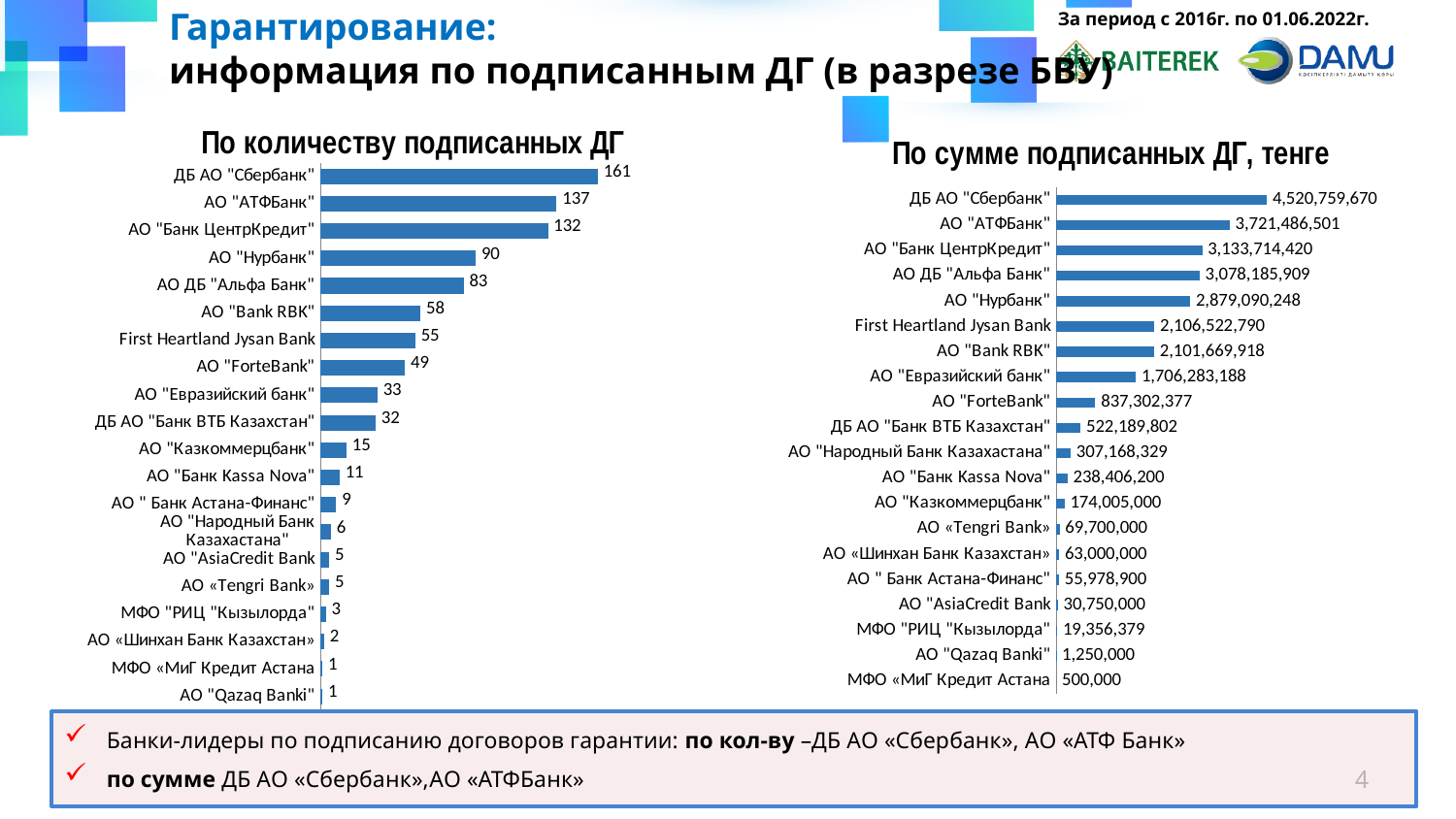
In the chart "По количеству подписанных ДГ", what is the value for АО "Нурбанк"? 90 What is the title of the chart on the right side of the slide? По сумме подписанных ДГ, тенге In the chart "По количеству подписанных ДГ", how many banks are listed? 20 In the chart "По количеству подписанных ДГ", what is the value for АО "Bank RBK"? 58 In the chart "По сумме подписанных ДГ, тенге", which bank has the lowest value? МФО «МиГ Кредит Астана In the chart "По сумме подписанных ДГ, тенге", what is the value for ДБ АО "Сбербанк"? 4,520,759,670 What type of chart is "По количеству подписанных ДГ"? Bar chart In the chart "По сумме подписанных ДГ, тенге", what is the difference between АО «Tengri Bank» and АО «Шинхан Банк Казахстан»? 6,700,000 In the chart "По сумме подписанных ДГ, тенге", what is the value for АО "ForteBank"? 837,302,377 In the chart "По количеству подписанных ДГ", which bank has the highest value? ДБ АО "Сбербанк" In the chart "По сумме подписанных ДГ, тенге", which is larger: АО ДБ "Альфа Банк" or АО "Нурбанк"? АО ДБ "Альфа Банк" In the chart "По количеству подписанных ДГ", what is the difference between ДБ АО "Сбербанк" and АО "АТФБанк"? 24